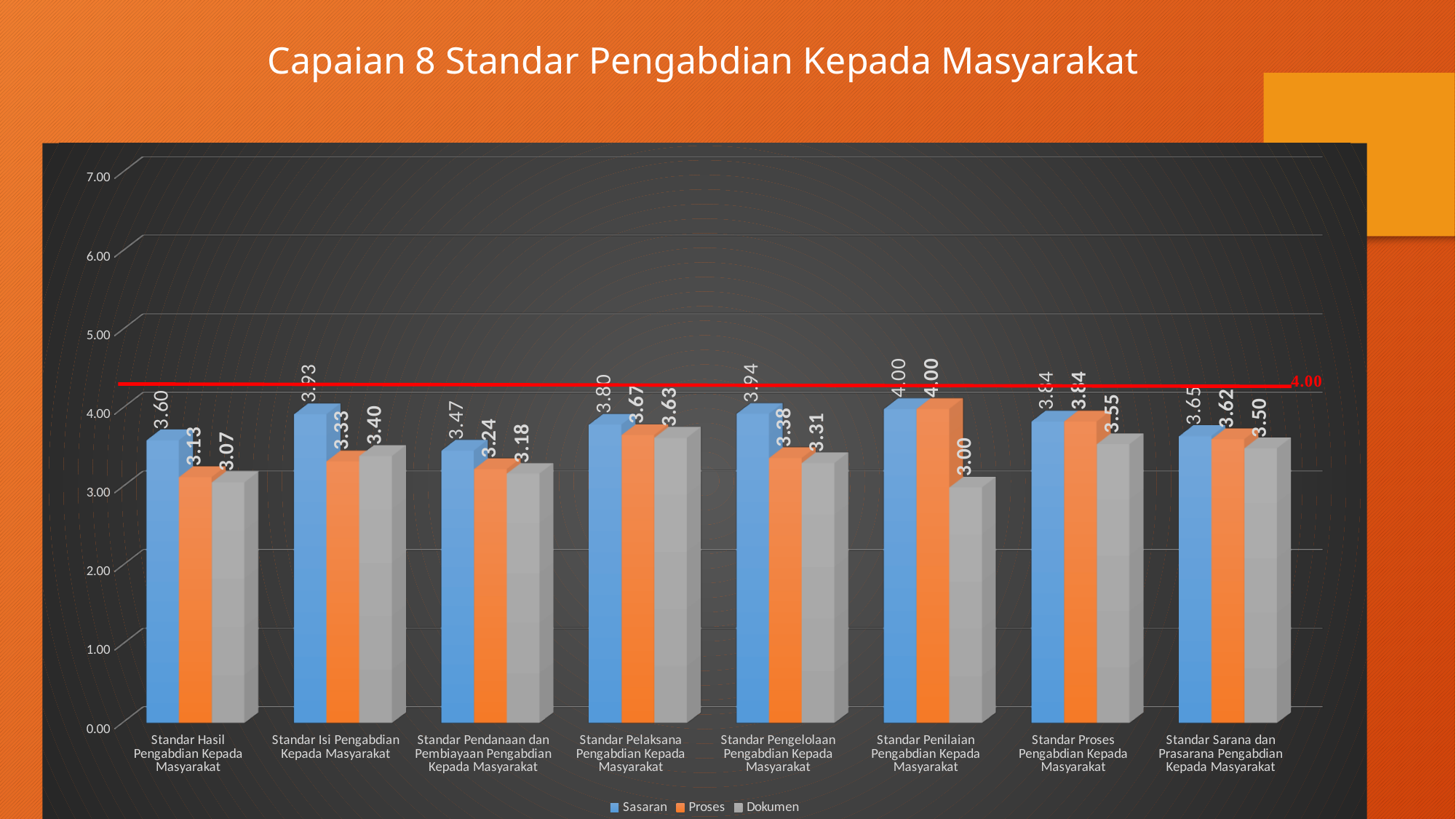
For Standar Isi Pengabdian Kepada Masyarakat, which is larger: the Proses value or the Dokumen value? Dokumen Which category has the lowest Sasaran value? Standar Pendanaan dan Pembiayaan Pengabdian Kepada Masyarakat How many series does the legend list? 3 What is the Sasaran value for Standar Hasil Pengabdian Kepada Masyarakat? 3.60 What is the Dokumen value for Standar Penilaian Pengabdian Kepada Masyarakat? 3.00 What kind of chart is shown on the slide? Bar chart Which category has the lowest Dokumen value? Standar Penilaian Pengabdian Kepada Masyarakat What is the Proses value for Standar Pelaksana Pengabdian Kepada Masyarakat? 3.67 What value is marked by the red horizontal line across the chart? 4.00 How many categories are shown on the x axis? 8 Which category has the highest Sasaran value? Standar Penilaian Pengabdian Kepada Masyarakat What is the difference between the Sasaran and Proses values for Standar Hasil Pengabdian Kepada Masyarakat? 0.47